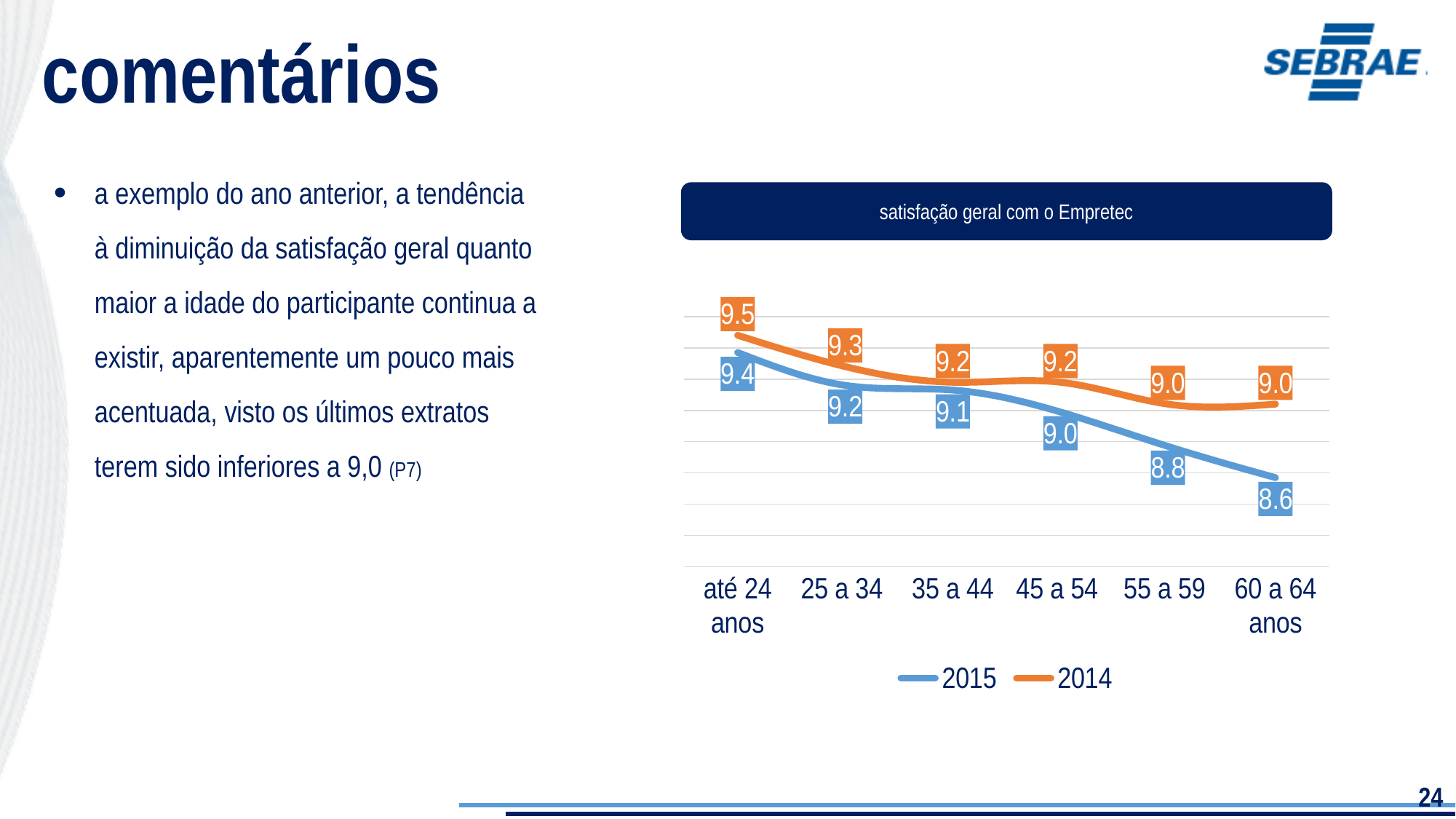
What is the difference between the 2014 and 2015 values for the '60 a 64 anos' age group? 0.4 What is the 2015 value for the '60 a 64 anos' age group? 8.6 Do the 2015 values rise or fall as age increases along the x axis? Fall What kind of chart is shown on the slide? Line chart What is the 2015 value for the 'até 24 anos' age group? 9.4 How many age groups are shown on the x axis? 6 How many series does the legend list? 2 Which age group has the highest 2014 value? até 24 anos What is the 2014 value for the '45 a 54' age group? 9.2 What is the 2014 value for the '55 a 59' age group? 9.0 For the '45 a 54' age group, which series has the larger value, 2015 or 2014? 2014 Which age group has the lowest 2015 value? 60 a 64 anos